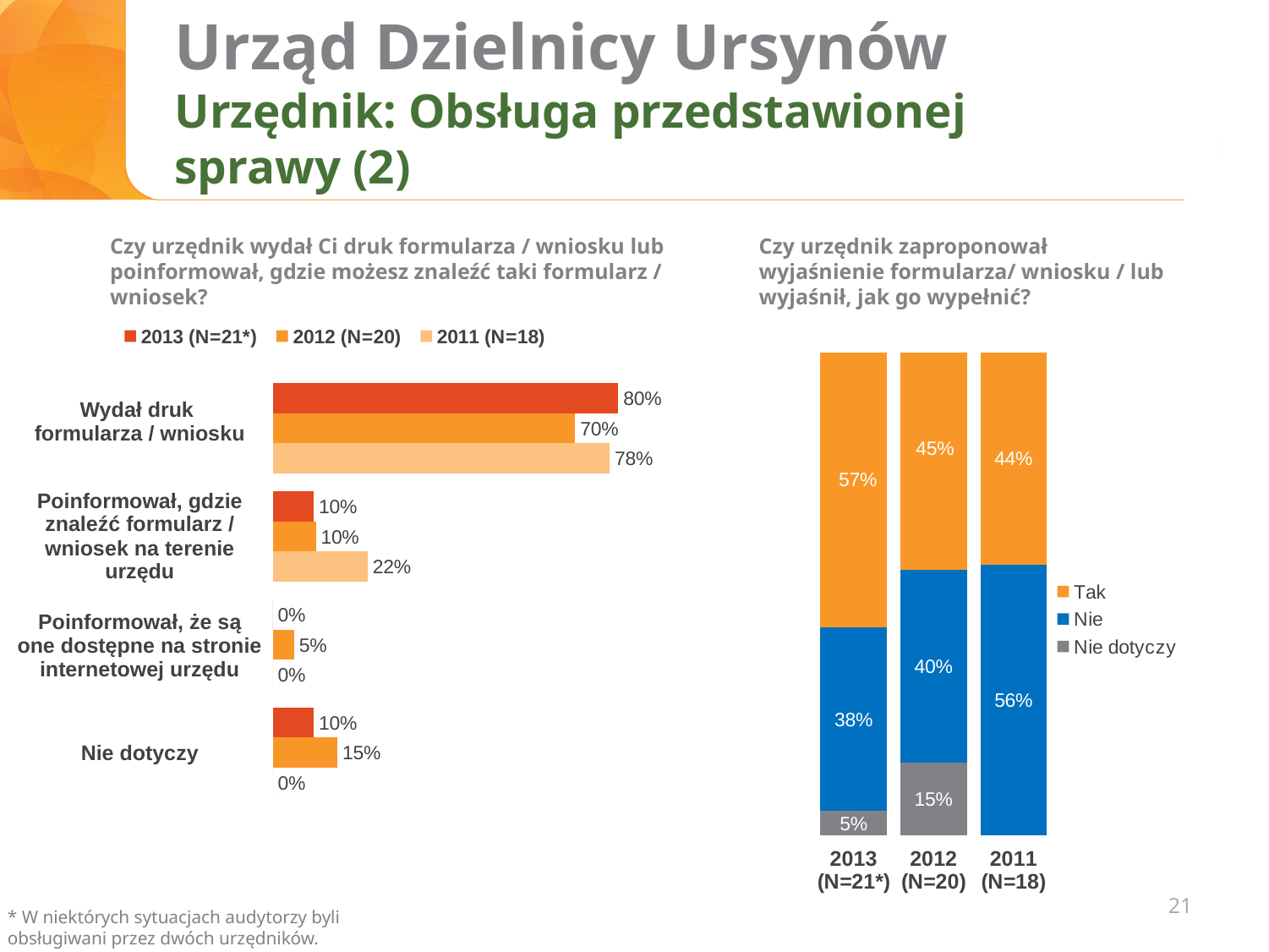
In the left chart, which category has the highest value for the 2012 (N=20) series? Wydał druk formularza / wniosku In the left chart, how many series does the legend list? 3 In the left chart, what is the difference between the 2013 (N=21*) and 2012 (N=20) values for 'Wydał druk formularza / wniosku'? 10% In the right chart, what is the 'Nie' value for 2011 (N=18)? 56% In the left chart, what is the 2011 (N=18) value for 'Poinformował, gdzie znaleźć formularz / wniosek na terenie urzędu'? 22% In the left chart, what is the 2012 (N=20) value for 'Nie dotyczy'? 15% What kind of chart is the chart on the right? Stacked bar chart In the right chart, is the 'Tak' value for 2013 (N=21*) larger or smaller than the 'Nie' value for 2013 (N=21*)? Larger In the right chart, which year has the highest 'Tak' value? 2013 (N=21*) In the left chart, what is the 2013 (N=21*) value for 'Wydał druk formularza / wniosku'? 80% In the left chart, how many categories are shown? 4 In the right chart, what is the 'Nie dotyczy' value for 2012 (N=20)? 15%